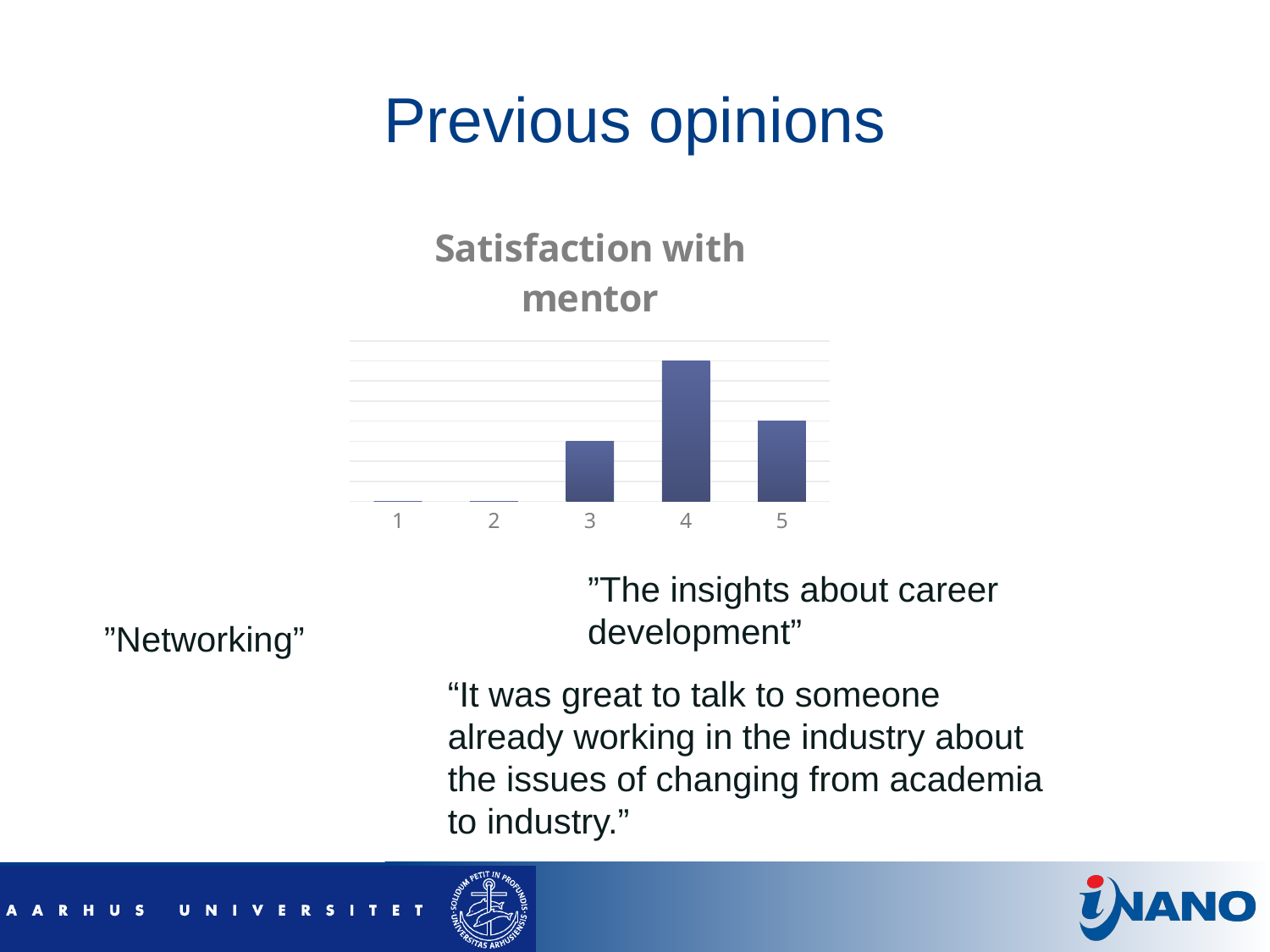
What is the title of the chart on the slide? Satisfaction with mentor Which is larger in the Satisfaction with mentor chart, the value for 4 or the value for 5? 4 What are the category labels on the x axis of the Satisfaction with mentor chart? 1, 2, 3, 4, 5 Do the values in the Satisfaction with mentor chart rise or fall from category 2 to category 4? rise Which category has the highest bar in the Satisfaction with mentor chart? 4 Which is larger in the Satisfaction with mentor chart, the value for 2 or the value for 3? 3 Do the values in the Satisfaction with mentor chart rise or fall from category 4 to category 5? fall What kind of chart is shown on the slide? bar chart How many categories are shown on the x axis of the chart? 5 Which is larger in the Satisfaction with mentor chart, the value for 3 or the value for 5? 5